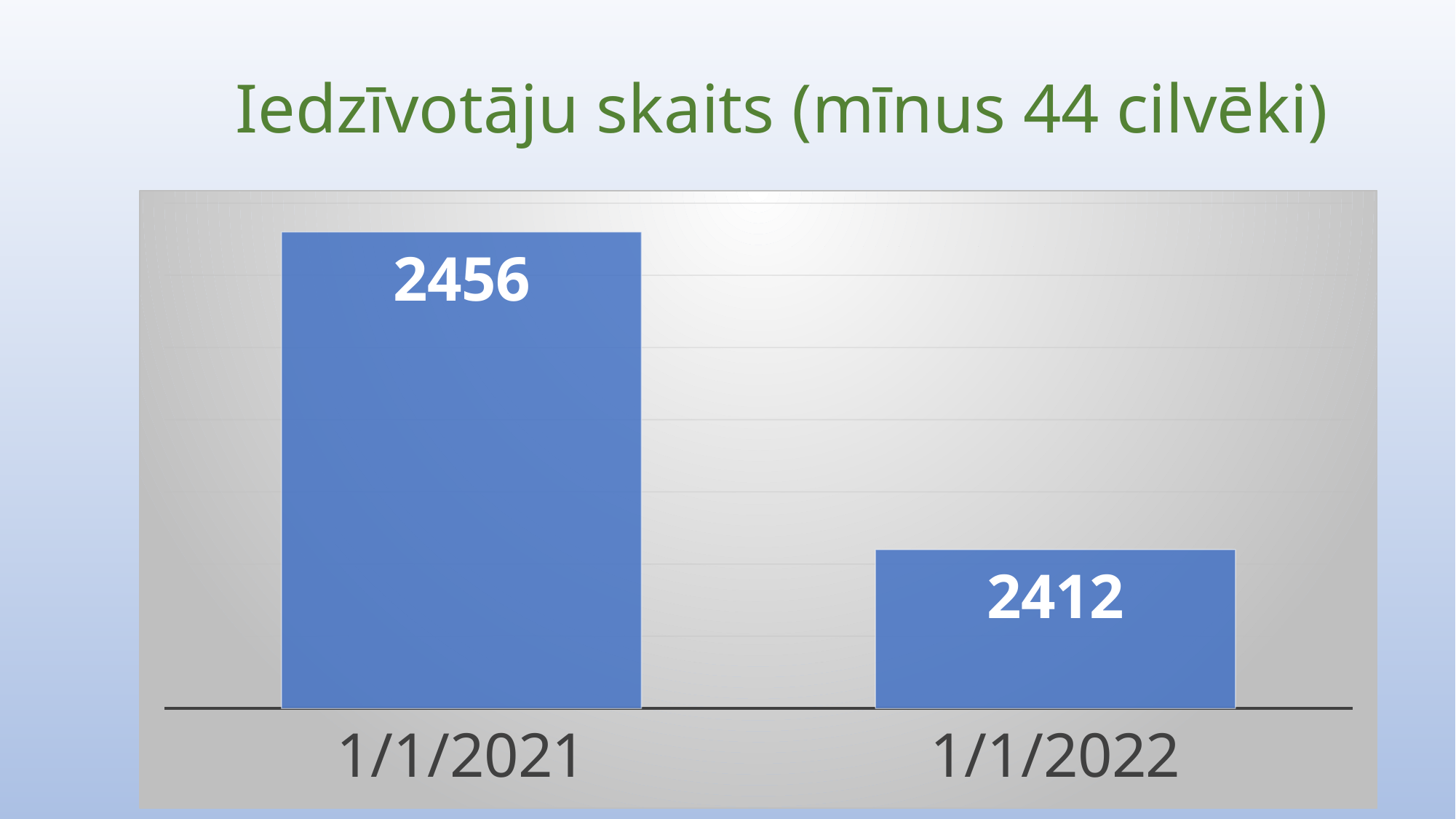
What kind of chart is shown on the slide? bar chart Which category has the lowest value? 1/1/2022 What is the value for 1/1/2021? 2456 Do the values rise or fall from 1/1/2021 to 1/1/2022? fall What is the value for 1/1/2022? 2412 What colour are the bars in the chart? blue Which category has the highest value? 1/1/2021 How many categories are shown in the chart? 2 What is the difference between the values for 1/1/2021 and 1/1/2022? 44 Which is larger, the value for 1/1/2021 or the value for 1/1/2022? 1/1/2021 What is the title of the chart? Iedzīvotāju skaits (mīnus 44 cilvēki)